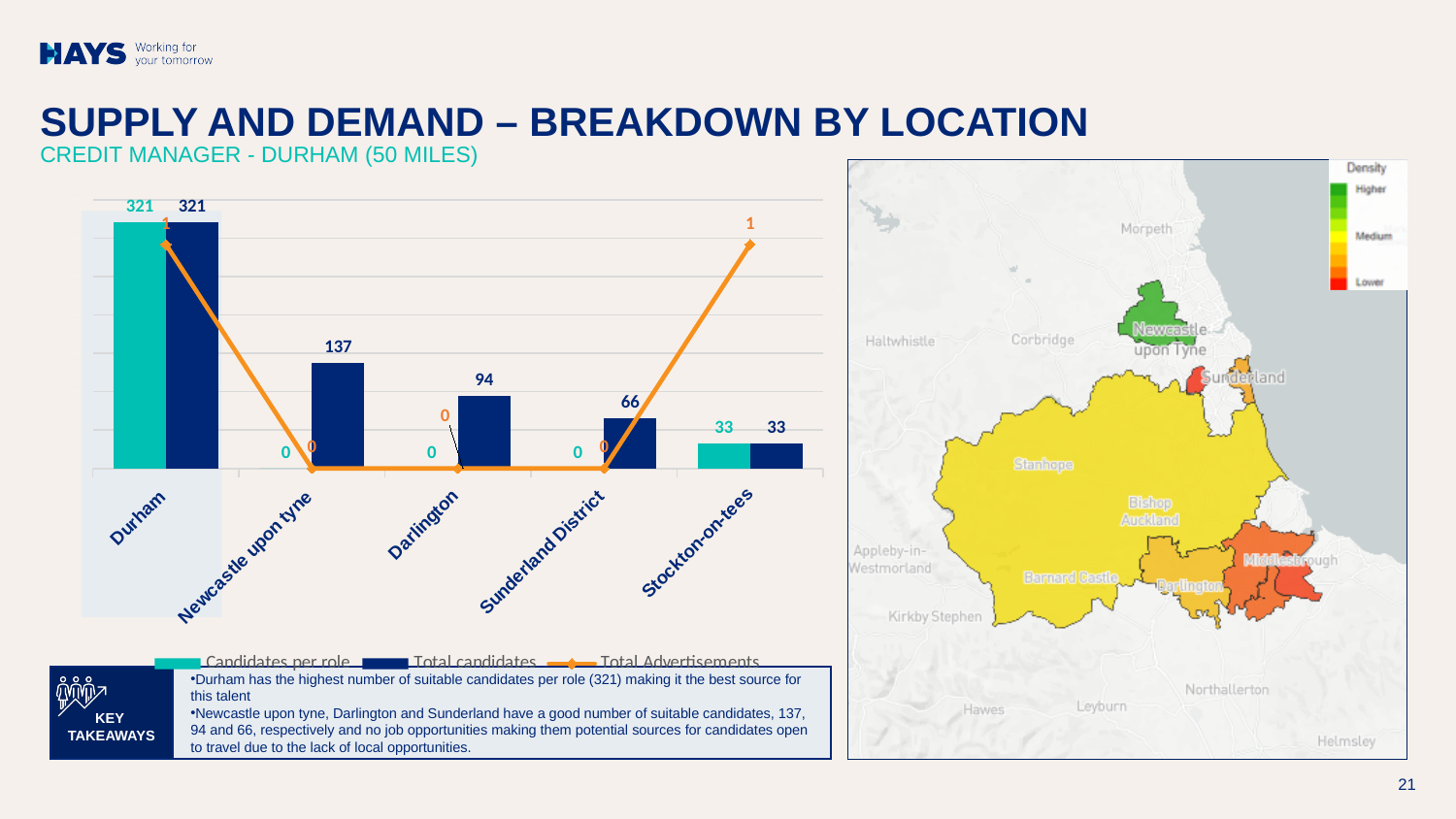
How many locations are shown on the x axis of the chart? 5 Which location has the highest Total candidates value? Durham Which series is plotted as a line rather than bars? Total Advertisements What is the Total candidates value for Darlington? 94 What is the Total Advertisements value for Durham? 1 Which has a larger Total candidates value, Darlington or Sunderland District? Darlington Which location has the lowest Total candidates value? Stockton-on-tees What is the Total Advertisements value for Darlington? 0 What is the difference between the Total candidates values for Durham and Sunderland District? 255 How many series does the chart legend list? 3 What is the Candidates per role value for Stockton-on-tees? 33 What is the Total candidates value for Newcastle upon tyne? 137